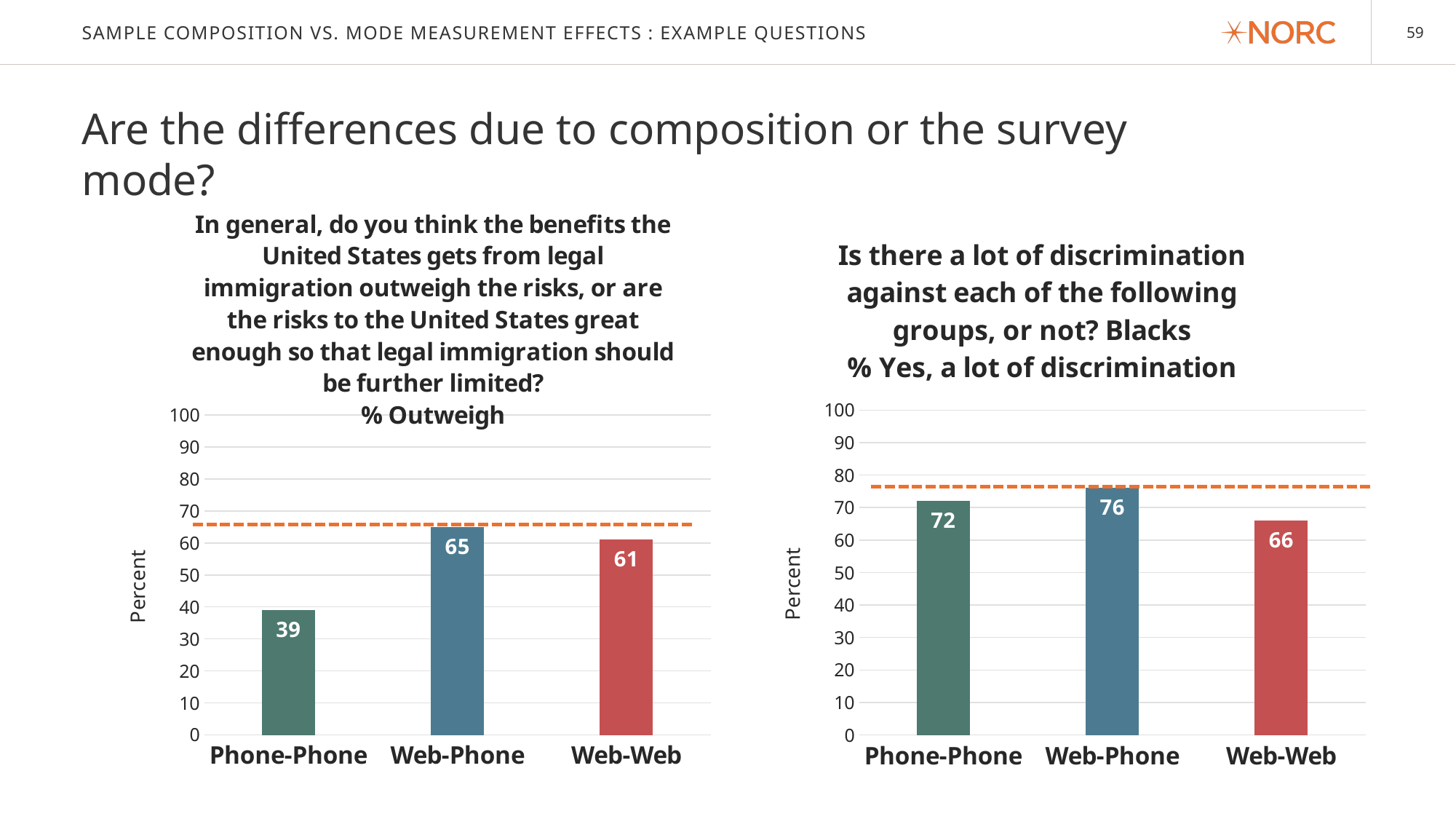
How many categories are shown on the x axis of the left chart (legal immigration, % Outweigh)? 3 In the left chart (legal immigration, % Outweigh), what is the value for Web-Web? 61 What is the y-axis label of the left chart (legal immigration, % Outweigh)? Percent In the right chart (discrimination against Blacks), what is the difference between the Web-Phone and Phone-Phone values? 4 In the right chart (discrimination against Blacks), what is the value for Web-Web? 66 In the right chart (discrimination against Blacks), which is larger, the value for Phone-Phone or Web-Web? Phone-Phone In the right chart (discrimination against Blacks), which category has the lowest value? Web-Web In the right chart (discrimination against Blacks), what is the value for Web-Phone? 76 In the left chart (legal immigration, % Outweigh), which category has the highest value? Web-Phone In the left chart (legal immigration, % Outweigh), what is the value for Phone-Phone? 39 In the left chart (legal immigration, % Outweigh), what is the difference between the Web-Phone and Phone-Phone values? 26 What kind of chart is the right chart (discrimination against Blacks)? Bar chart